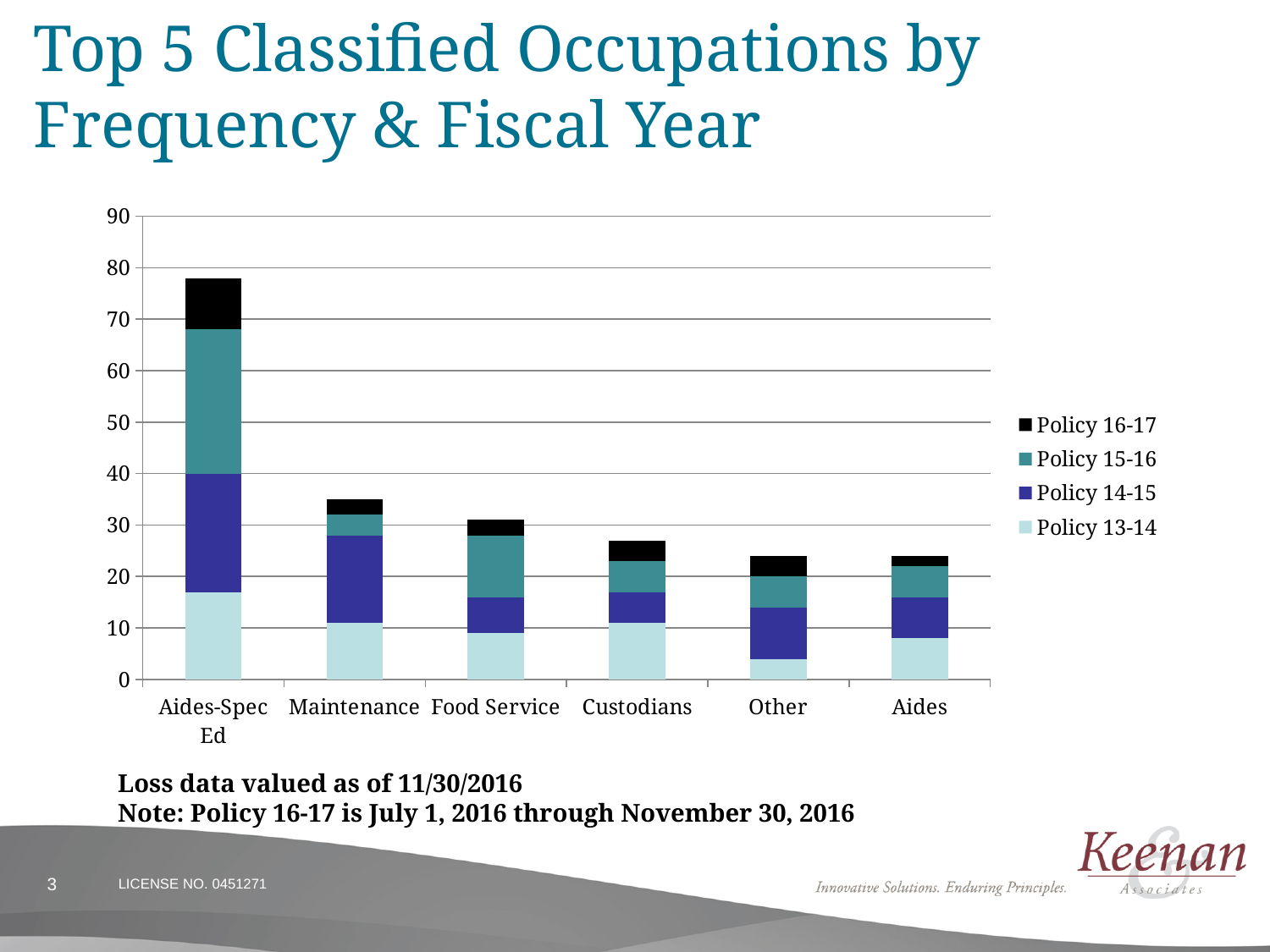
How many occupation categories are shown on the x axis? 6 What is the title of the slide containing the chart? Top 5 Classified Occupations by Frequency & Fiscal Year How many series does the legend list? 4 Is the Policy 13-14 value for Other greater or less than 10? less Is the Policy 13-14 value for Aides-Spec Ed greater or less than 10? greater What kind of chart is shown on the slide? stacked bar chart Is the total stacked value for Custodians greater or less than 30? less Which series is shown in black in the legend? Policy 16-17 Which occupation has the tallest stacked bar overall? Aides-Spec Ed Which has the larger total stacked bar, Maintenance or Custodians? Maintenance